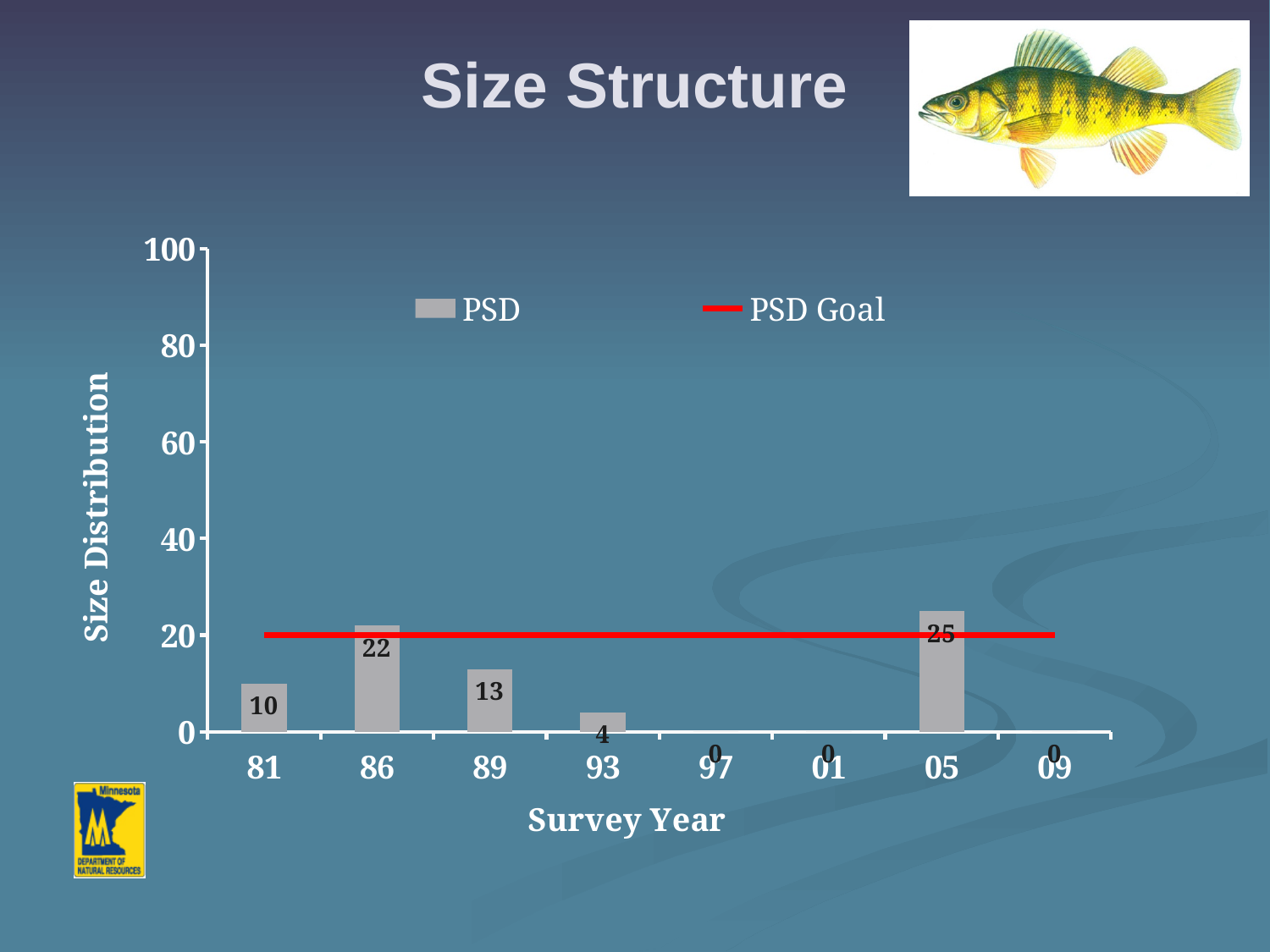
Which survey year has the highest PSD value? 05 Which is larger, the PSD value for survey year 86 or for survey year 89? 86 What is the PSD value for survey year 86? 22 How many survey years are shown on the x axis? 8 How many series does the legend list? 2 What is the label of the y axis? Size Distribution What is the PSD value for survey year 05? 25 What is the difference between the PSD values for survey years 05 and 81? 15 What is the title of the slide? Size Structure What is the PSD value for survey year 93? 4 Is the PSD value for survey year 05 greater or less than 20? greater What kind of chart is shown on the slide? combination bar and line chart